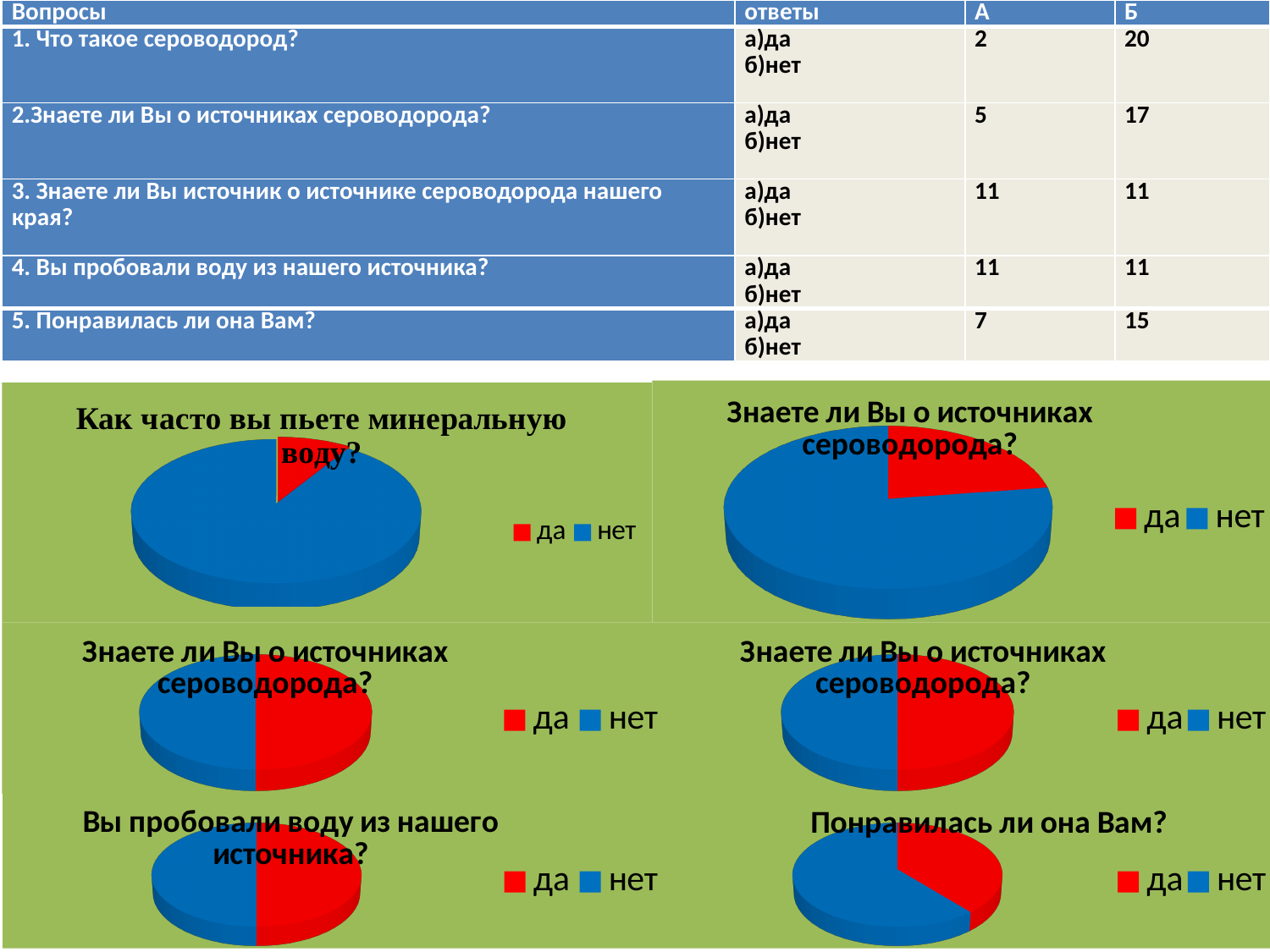
In the top-right chart "Знаете ли Вы о источниках сероводорода?", which slice is larger, "да" or "нет"? нет How many entries does the legend of the top-left chart "Как часто вы пьете минеральную воду?" list? 2 What is the title of the bottom-right chart on the slide? Понравилась ли она Вам? How many pie charts are shown on the slide? 6 In the bottom-right chart "Понравилась ли она Вам?", what colour represents "да" in the legend? red What kind of chart is the top-left chart titled "Как часто вы пьете минеральную воду?"? pie chart What kind of chart is the bottom-right chart "Понравилась ли она Вам?"? pie chart In the top-left chart "Как часто вы пьете минеральную воду?", which slice is larger, "да" or "нет"? нет In the bottom-right chart "Понравилась ли она Вам?", which slice is larger, "да" or "нет"? нет How many slices does the bottom-left chart "Вы пробовали воду из нашего источника?" have? 2